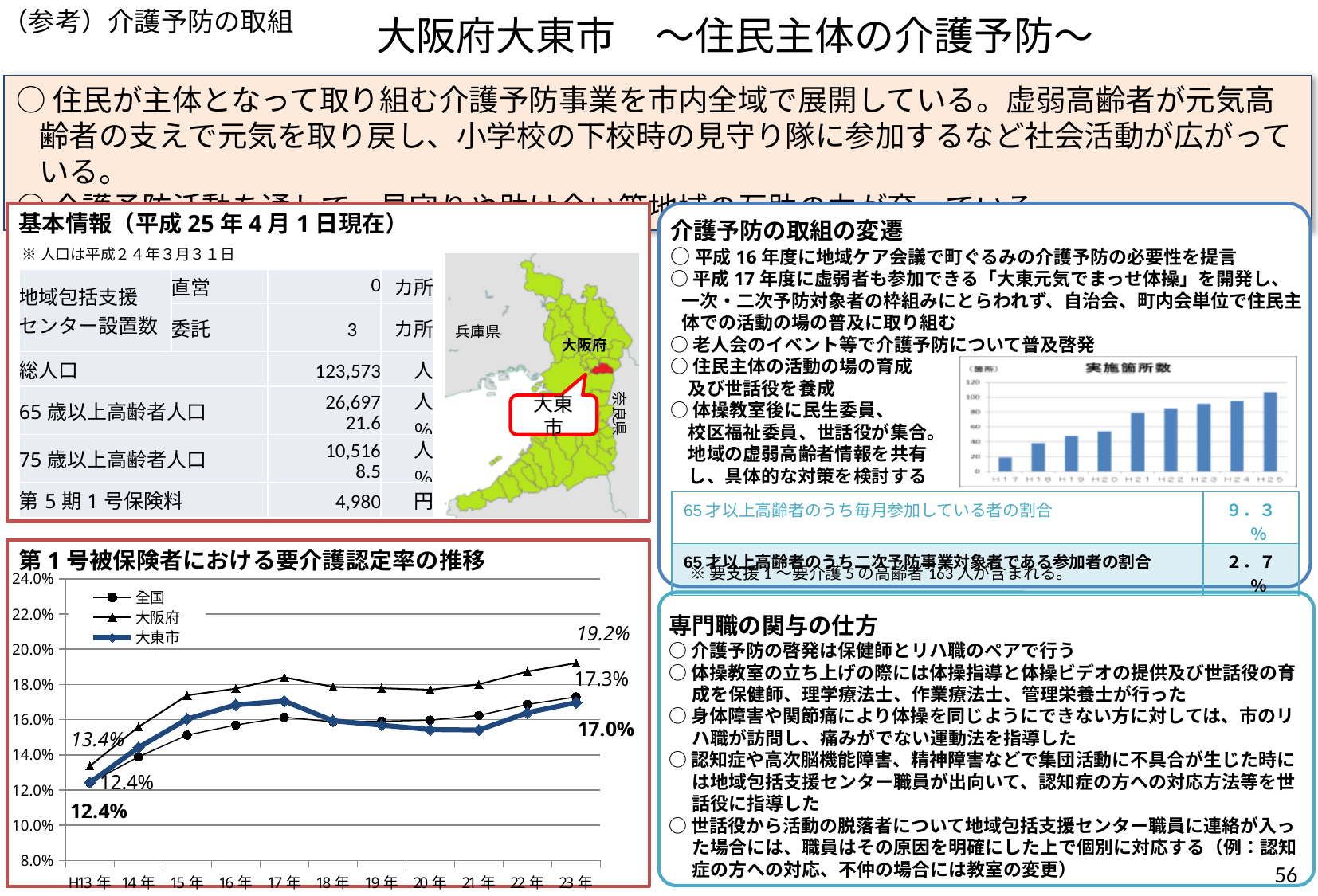
In the 第1号被保険者における要介護認定率の推移 chart, what is the difference between 大阪府 and 大東市 in 23年? 2.2% In the 第1号被保険者における要介護認定率の推移 chart, what is the value for 大阪府 in 23年? 19.2% What kind of chart is the 実施箇所数 chart? bar chart How many bars are in the 実施箇所数 chart? 9 In the 第1号被保険者における要介護認定率の推移 chart, what is the value for 大東市 in H13年? 12.4% How many series does the legend of the 第1号被保険者における要介護認定率の推移 chart list? 3 What kind of chart is the 第1号被保険者における要介護認定率の推移 chart? line chart In the 第1号被保険者における要介護認定率の推移 chart, does the 大東市 line rise or fall overall from H13年 to 23年? rise In the 実施箇所数 chart, is the value for H21 greater or less than 60? greater In the 第1号被保険者における要介護認定率の推移 chart, what is the value for 大東市 in 23年? 17.0% In the 第1号被保険者における要介護認定率の推移 chart, which is higher in 23年, 大阪府 or 全国? 大阪府 In the 実施箇所数 chart, which year has the highest value? H25